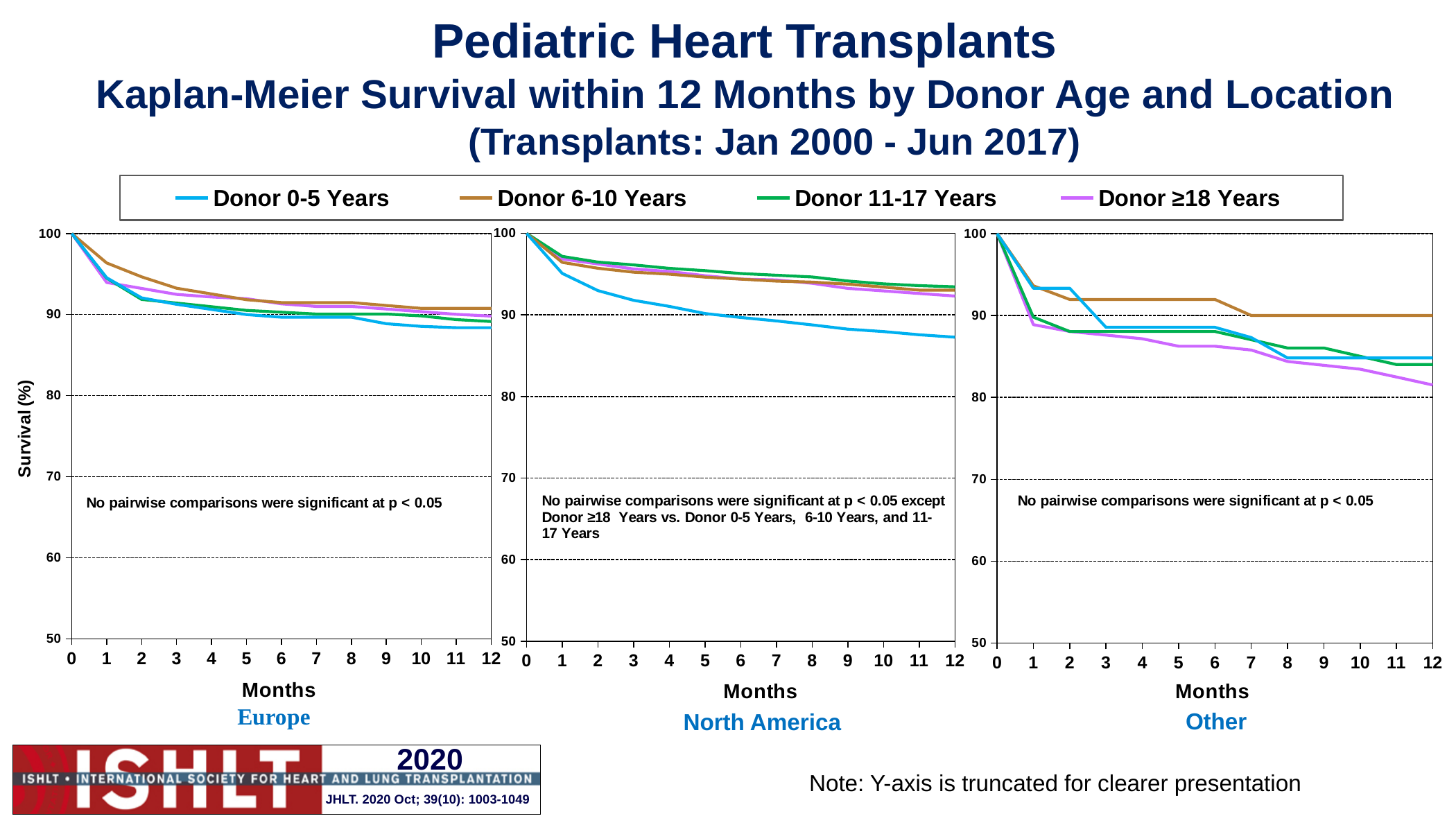
In the Europe chart, is the value for Donor 0-5 Years at 12 months greater or less than 90? less How many series does the legend list? 4 In the Other chart, which series is highest at 12 months? Donor 6-10 Years What kind of chart is used for the Europe panel? line chart In the Other chart, is the value for Donor ≥18 Years at 12 months greater or less than 90? less In the North America chart, at 12 months, which is larger: Donor 0-5 Years or Donor 6-10 Years? Donor 6-10 Years In the Europe chart, does the Donor 0-5 Years line rise or fall from 0 to 12 months? fall What is the y-axis label of the Europe chart? Survival (%) In the North America chart, which series is lowest at 12 months? Donor 0-5 Years In the Other chart, which series is lowest at 12 months? Donor ≥18 Years In the North America chart, is the value for Donor 0-5 Years at 12 months greater or less than 90? less